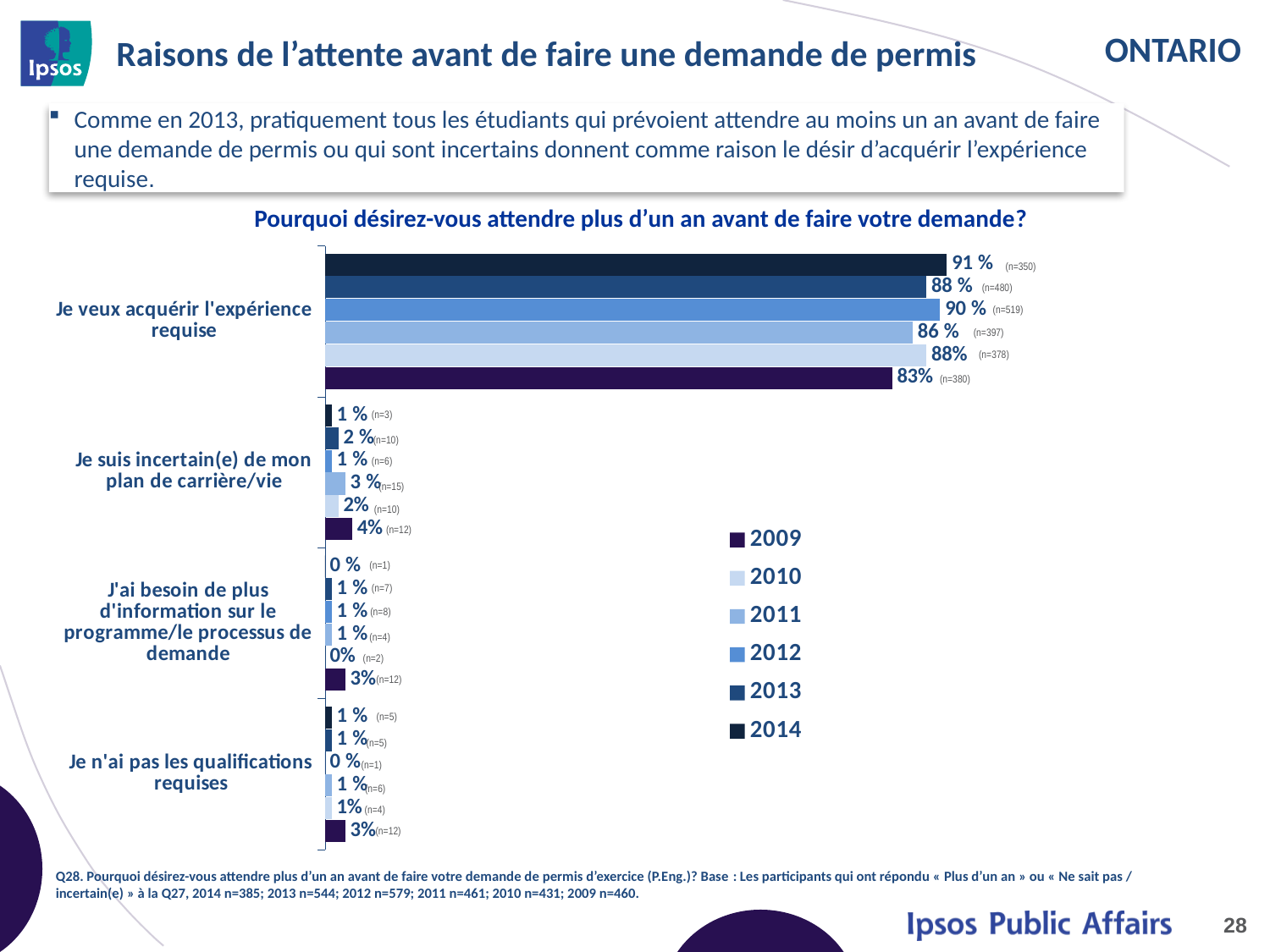
What is the 2011 value for "Je suis incertain(e) de mon plan de carrière/vie"? 3 % For "Je veux acquérir l'expérience requise", is the 2012 value larger or smaller than the 2011 value? larger What kind of chart is shown on the slide? bar chart What is the title of the chart? Pourquoi désirez-vous attendre plus d'un an avant de faire votre demande? Which year has the lowest value for "Je veux acquérir l'expérience requise"? 2009 How many series does the legend list? 6 What is the 2014 value for "Je veux acquérir l'expérience requise"? 91 % Which reason category has the highest values across all years? Je veux acquérir l'expérience requise How many reason categories are plotted on the chart? 4 What is the 2009 value for "Je veux acquérir l'expérience requise"? 83% Which year has the highest value for "Je veux acquérir l'expérience requise"? 2014 What is the difference between the 2014 and 2009 values for "Je veux acquérir l'expérience requise"? 8 percentage points